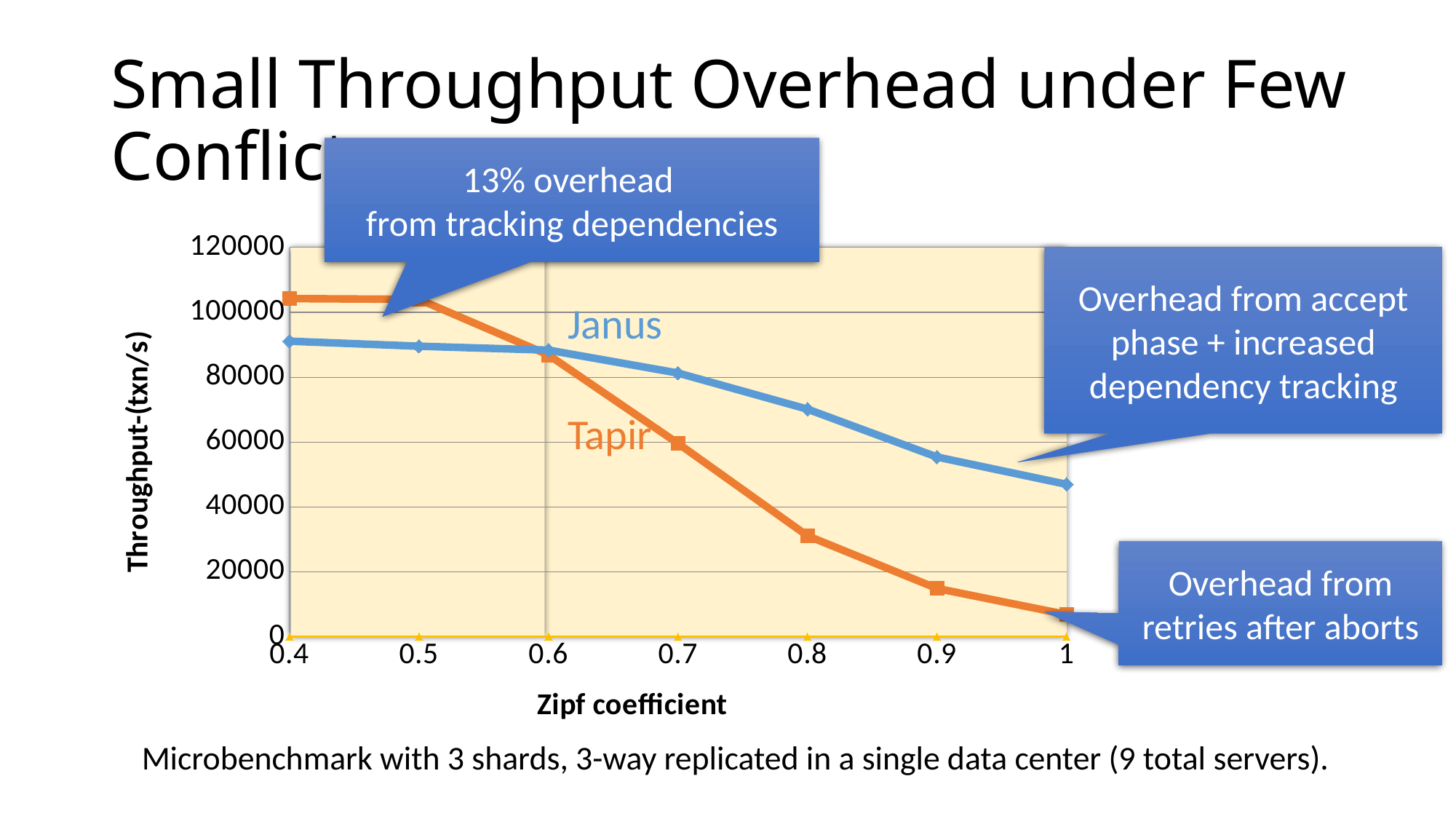
At Zipf coefficient 0.8, which has higher throughput, Janus or Tapir? Janus How many Zipf coefficient values are marked on the x axis? 7 Is the Tapir throughput at Zipf coefficient 0.8 greater or less than 40000? less Is the Janus throughput at Zipf coefficient 0.4 greater or less than 100000? less What is the label of the y axis? Throughput-(txn/s) What kind of chart is shown on the slide? line chart What is the label of the x axis? Zipf coefficient Is the Janus throughput at Zipf coefficient 1 greater or less than 40000? greater Does the Tapir throughput rise or fall as the Zipf coefficient increases from 0.4 to 1? fall At Zipf coefficient 0.4, which has higher throughput, Janus or Tapir? Tapir